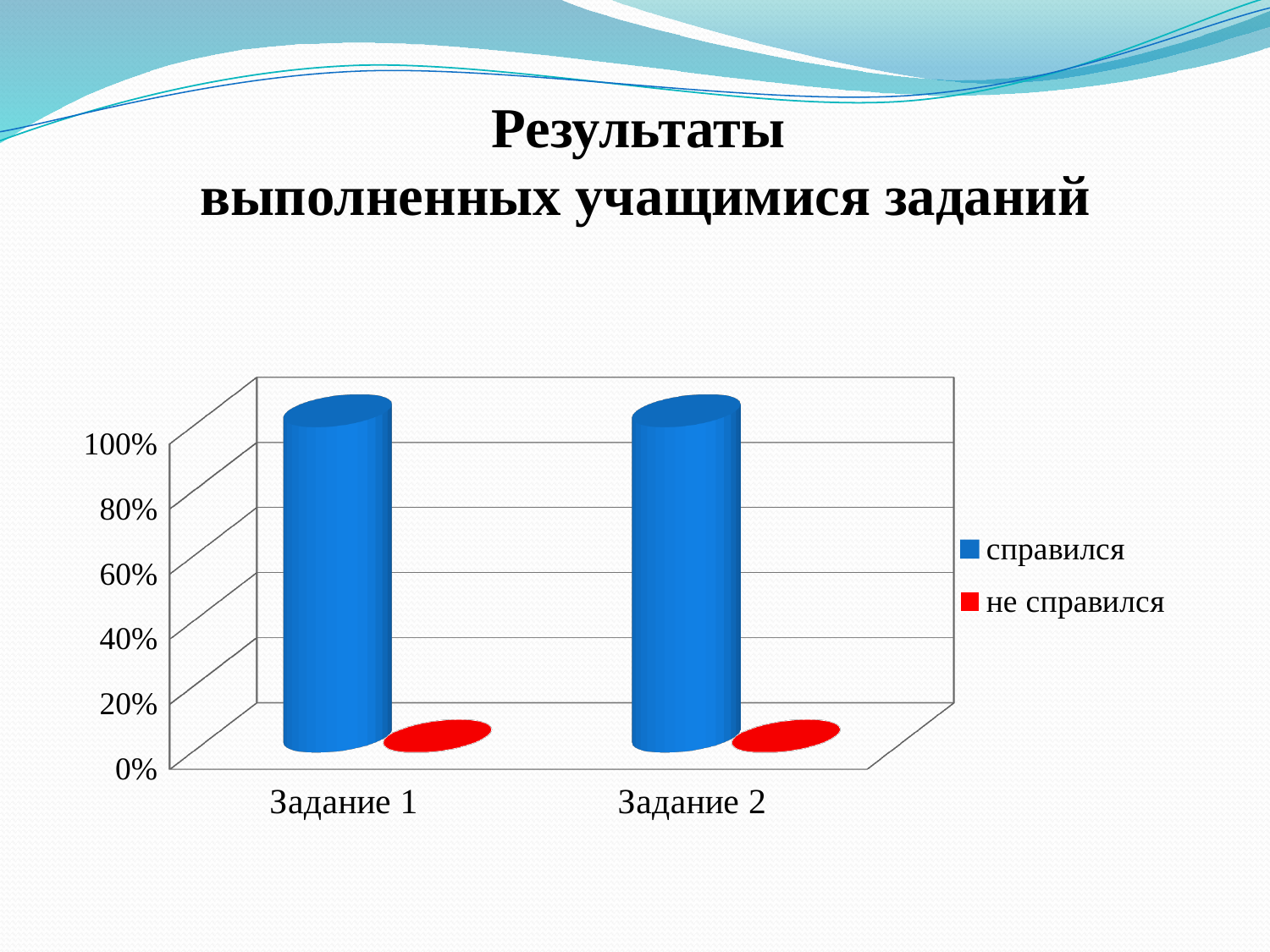
Is the value for "не справился" in Задание 2 greater or less than 20%? less What colour represents the "не справился" series in the chart? red How many categories are shown on the x axis of the chart? 2 What is the title of the slide above the chart? Результаты выполненных учащимися заданий What kind of chart is shown on the slide? bar chart Is the value for "не справился" in Задание 1 greater or less than 20%? less How many series does the chart legend list? 2 Is the value for "справился" in Задание 1 greater or less than 80%? greater For Задание 2, which series has the larger value: "справился" or "не справился"? справился For Задание 1, which series has the larger value: "справился" or "не справился"? справился